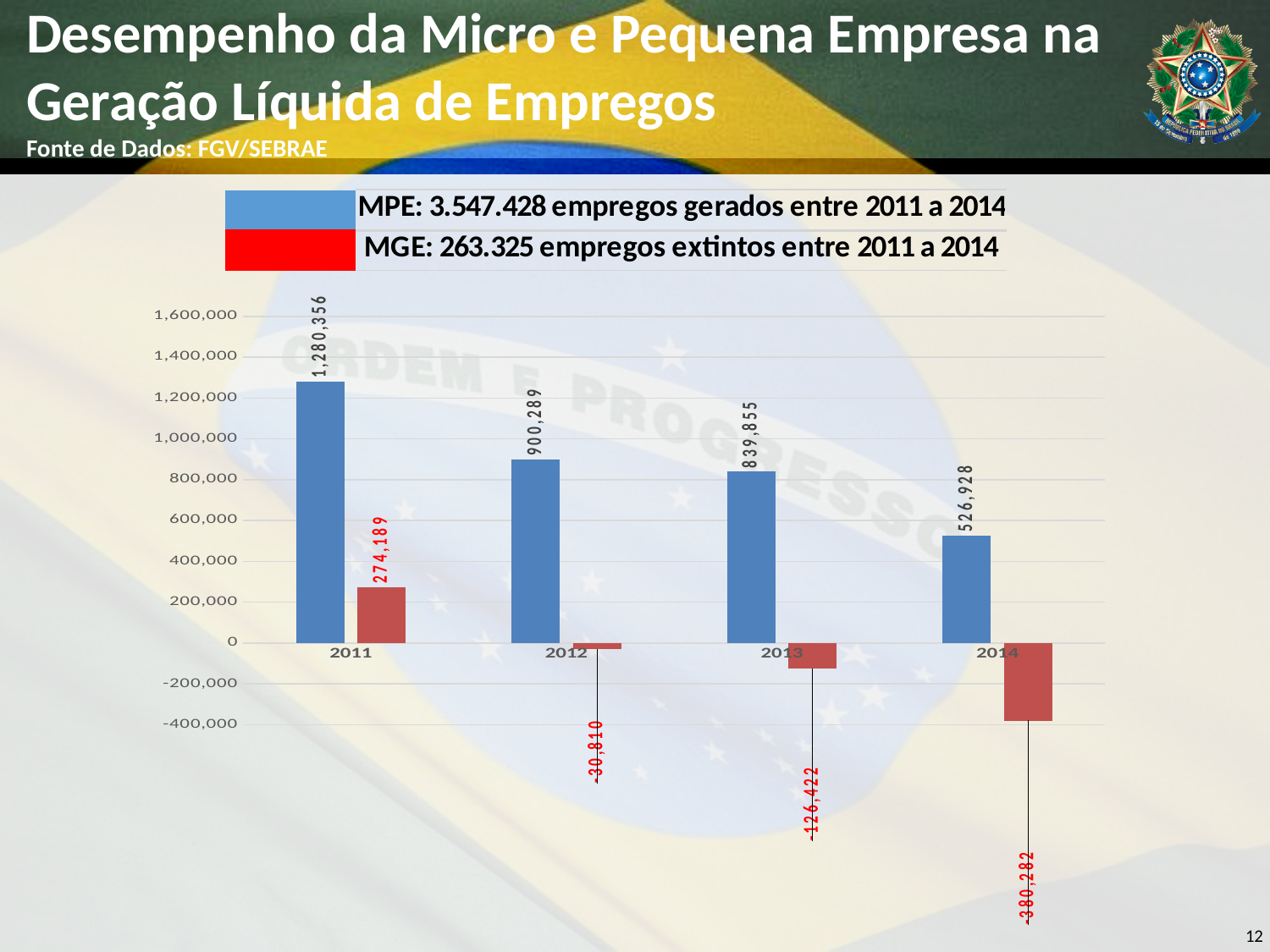
What kind of chart is shown on the slide? bar chart In which year is the MPE value highest? 2011 What is the MPE value for 2013? 839,855 What is the MGE value for 2014? -380,282 How many years are shown on the x axis? 4 Do the MPE values rise or fall from 2011 to 2014? fall How many series does the chart show? 2 In which year is the MGE value lowest? 2014 Which is larger, the MPE value for 2012 or the MPE value for 2013? 2012 What is the MPE value for 2011? 1,280,356 What is the MGE value for 2012? -30,810 What is the difference between the MPE values for 2011 and 2012? 380,067